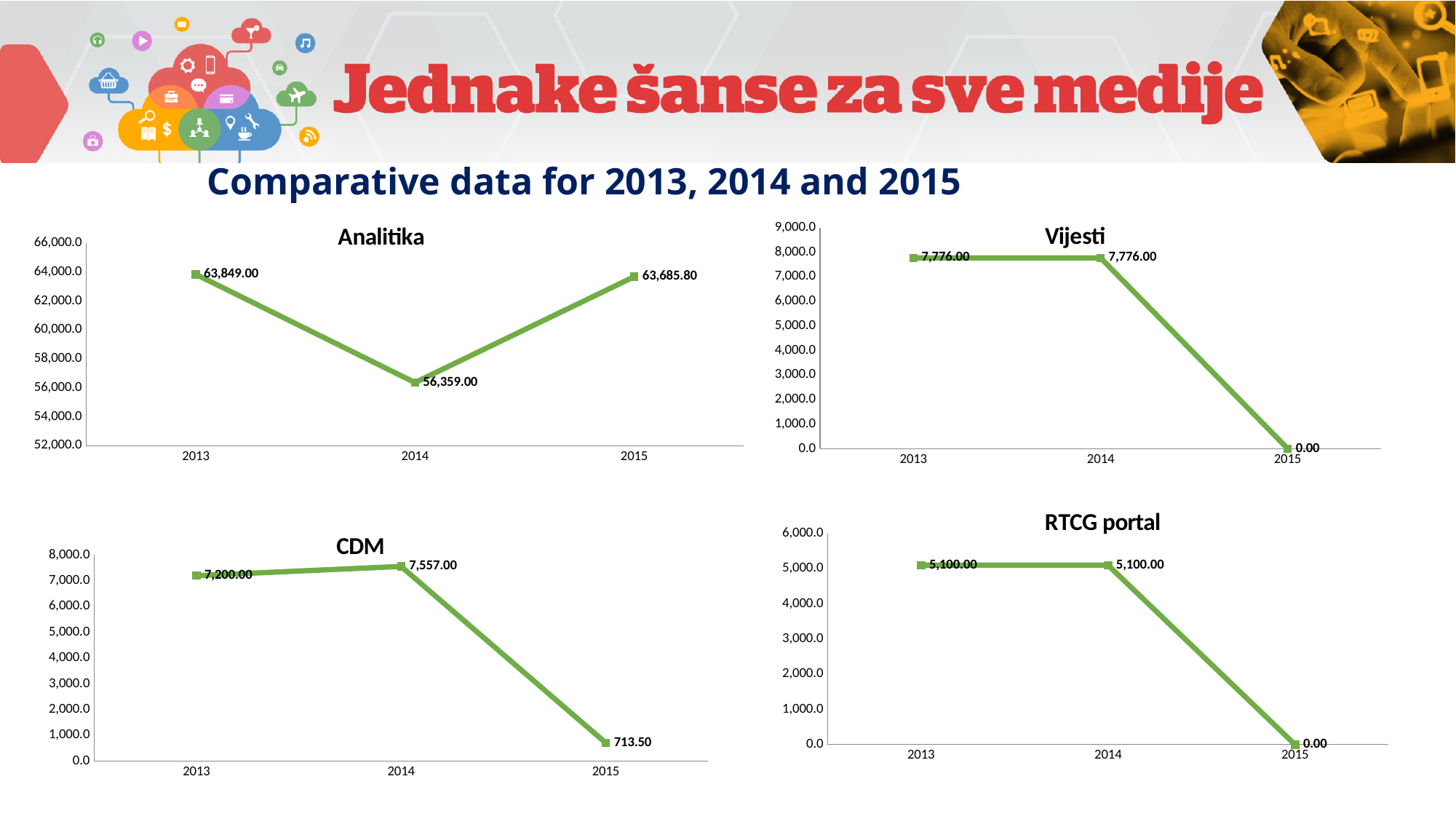
In the RTCG portal chart, what is the value for 2014? 5,100.00 In the RTCG portal chart, do the values rise or fall from 2014 to 2015? fall In the CDM chart, which year has the lowest value? 2015 In the Analitika chart, what is the value for 2014? 56,359.00 In the Vijesti chart, is the value for 2014 greater or less than 7,000.0? greater In the Analitika chart, which year has the highest value? 2013 What kind of chart is the Analitika chart? line chart In the Vijesti chart, what is the value for 2015? 0.00 In the CDM chart, what is the difference between the 2014 and 2013 values? 357.00 In the Analitika chart, what is the difference between the 2013 and 2015 values? 163.20 In the CDM chart, what is the value for 2013? 7,200.00 How many data points are plotted in the CDM chart? 3